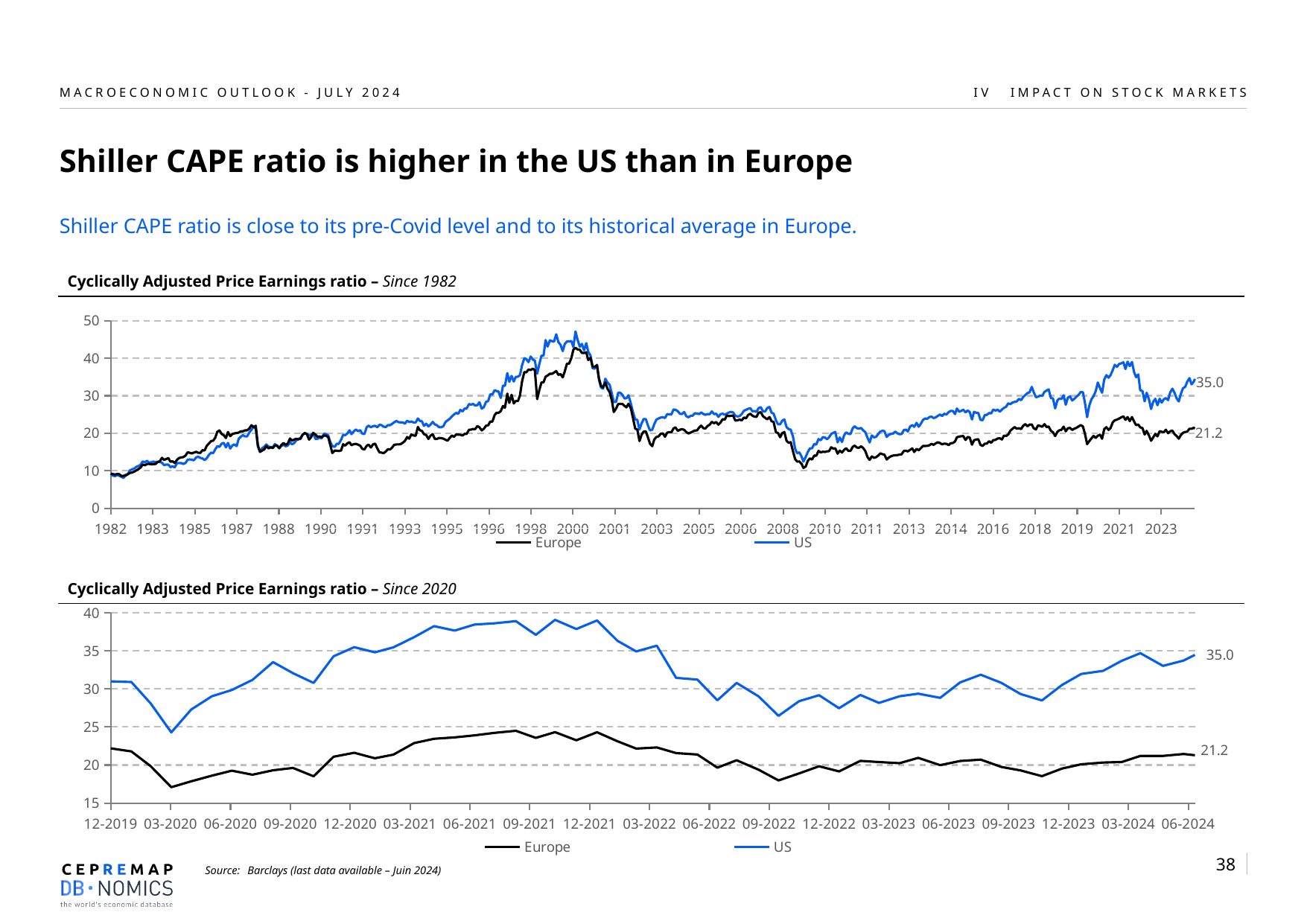
In the 'Since 1982' chart, what is the latest value shown for the US series? 35.0 In the 'Since 2020' chart, does the US series rise or fall between 12-2021 and 09-2022? fall Which colour is used for the US series in both charts? Blue In the 'Since 2020' chart, which series has the higher latest value, US or Europe? US How many series does the legend of the 'Since 2020' chart list? 2 What is the title of the bottom chart on the slide? Cyclically Adjusted Price Earnings ratio – Since 2020 In the 'Since 2020' chart, what is the difference between the latest US value and the latest Europe value? 13.8 In the 'Since 1982' chart, is the peak value of the US series around 2000 greater or less than 40? greater What kind of chart is the 'Since 1982' chart? Line chart In the 'Since 2020' chart, is the value for Europe in 03-2020 greater or less than 20? less In the 'Since 1982' chart, what is the latest value shown for the Europe series? 21.2 In the 'Since 1982' chart, is the value for Europe around 2008-2009 at its low point greater or less than 20? less